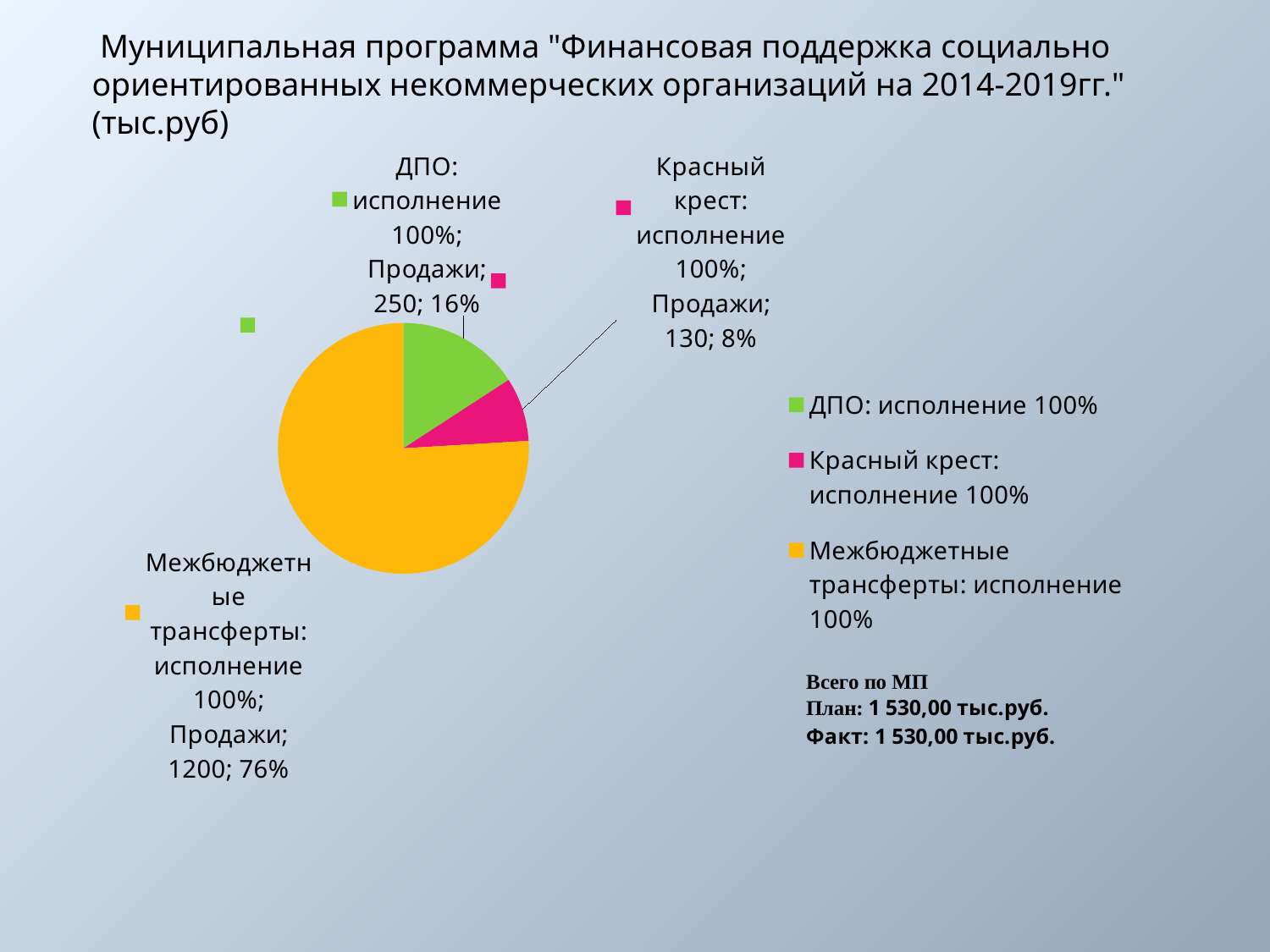
What is the difference between the values for "ДПО: исполнение 100%" and "Красный крест: исполнение 100%"? 120 What kind of chart is shown on the slide? pie chart How many entries does the legend of the pie chart list? 3 What is the value shown for the slice "Красный крест: исполнение 100%"? 130 Which slice of the pie chart is the largest? Межбюджетные трансферты: исполнение 100% What is the value shown for the slice "ДПО: исполнение 100%"? 250 What share of the pie does the slice "Межбюджетные трансферты: исполнение 100%" represent? 76% Which colour is used for the slice "Межбюджетные трансферты: исполнение 100%"? yellow Which slice of the pie chart is the smallest? Красный крест: исполнение 100% How many slices does the pie chart have? 3 What is the value shown for the slice "Межбюджетные трансферты: исполнение 100%"? 1200 What share of the pie does the slice "Красный крест: исполнение 100%" represent? 8%